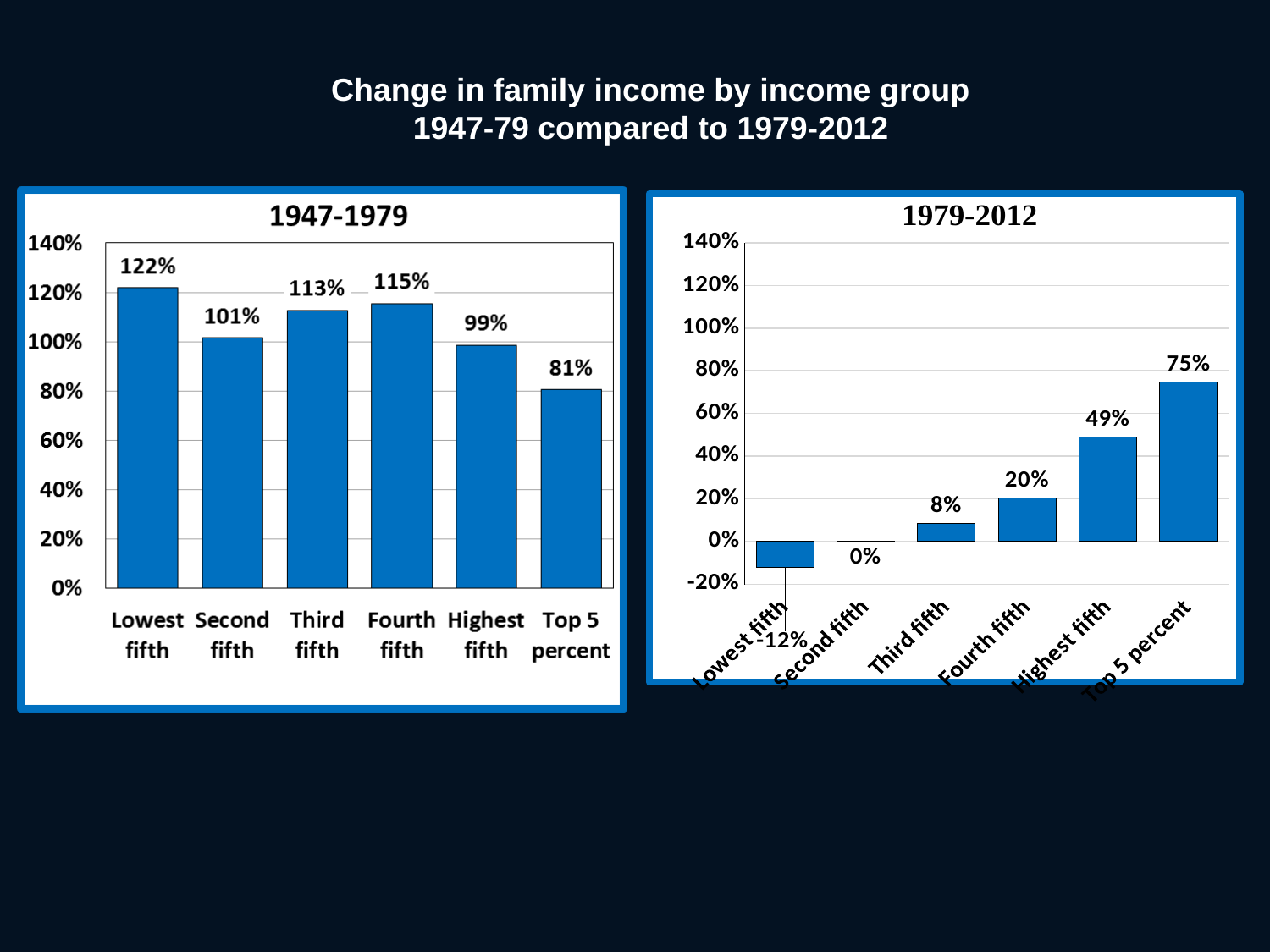
What kind of chart is the 1979-2012 chart? Bar chart In the 1947-1979 chart, which income group has the lowest value? Top 5 percent In the 1979-2012 chart, do the values rise or fall from the Lowest fifth to the Top 5 percent? Rise In the 1979-2012 chart, what is the value for the Highest fifth? 49% In the 1979-2012 chart, what is the difference between the Top 5 percent and the Highest fifth? 26% In the 1979-2012 chart, what is the value for the Lowest fifth? -12% In the 1947-1979 chart, which is larger, the Third fifth or the Fourth fifth? Fourth fifth In the 1947-1979 chart, what is the value for the Lowest fifth? 122% In the 1947-1979 chart, what is the difference between the Lowest fifth and the Top 5 percent? 41% In the 1979-2012 chart, which income group has the highest value? Top 5 percent In the 1947-1979 chart, how many income groups are shown? 6 In the 1947-1979 chart, which income group has the highest value? Lowest fifth